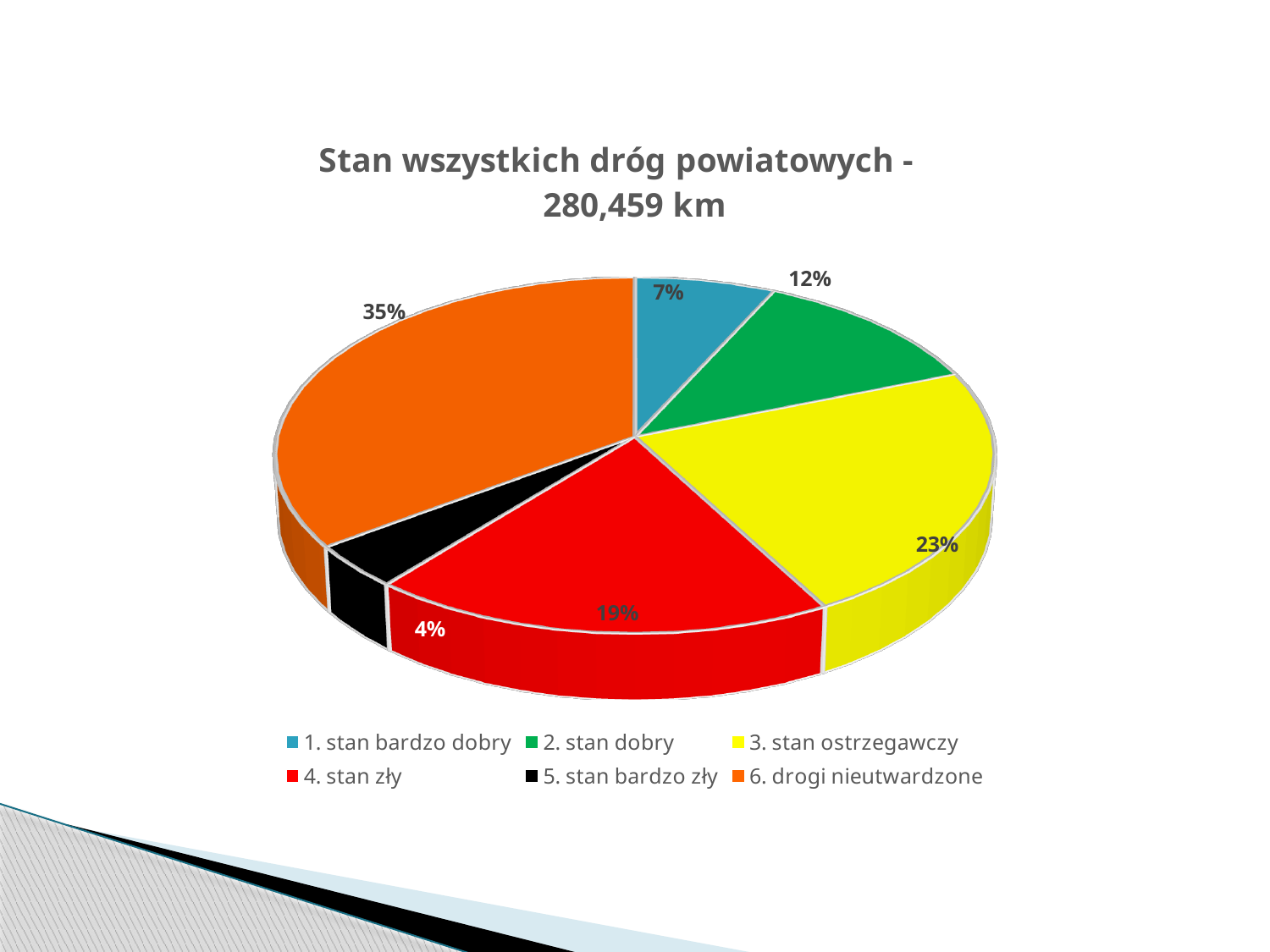
What share of the pie is '1. stan bardzo dobry'? 7% What type of chart is shown on the slide? pie chart What share of the pie is '4. stan zły'? 19% Which is larger, the share for '2. stan dobry' or the share for '1. stan bardzo dobry'? 2. stan dobry Which category has the smallest slice of the pie? 5. stan bardzo zły What share of the pie is '5. stan bardzo zły'? 4% What is the difference in percentage points between '3. stan ostrzegawczy' and '4. stan zły'? 4 What is the title of the chart? Stan wszystkich dróg powiatowych - 280,459 km Which category has the largest slice of the pie? 6. drogi nieutwardzone How many categories does the legend list? 6